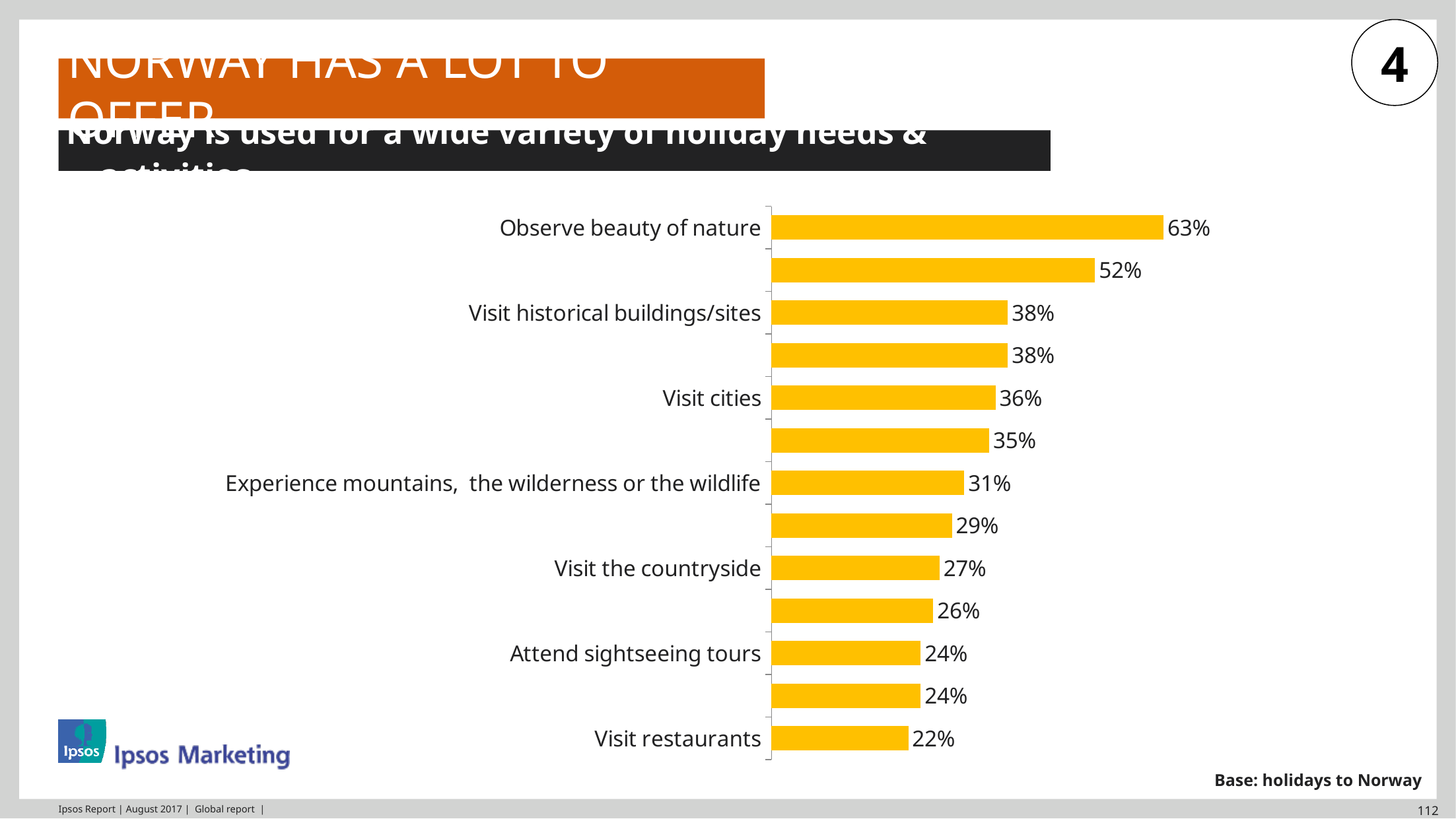
Which is larger: "Visit cities" or "Attend sightseeing tours"? Visit cities What percentage is shown for "Visit the countryside"? 27% What is the value for "Visit historical buildings/sites"? 38% What kind of chart is shown on the slide? Bar chart What is the value for "Visit restaurants"? 22% What is the value for "Experience mountains, the wilderness or the wildlife"? 31% Which labelled activity has the highest percentage? Observe beauty of nature How many bars are plotted in the chart? 13 What percentage is shown for "Visit cities"? 36% What percentage is shown for "Observe beauty of nature"? 63% What is the difference between "Observe beauty of nature" and "Visit restaurants"? 41 percentage points Which activity has the lowest percentage? Visit restaurants